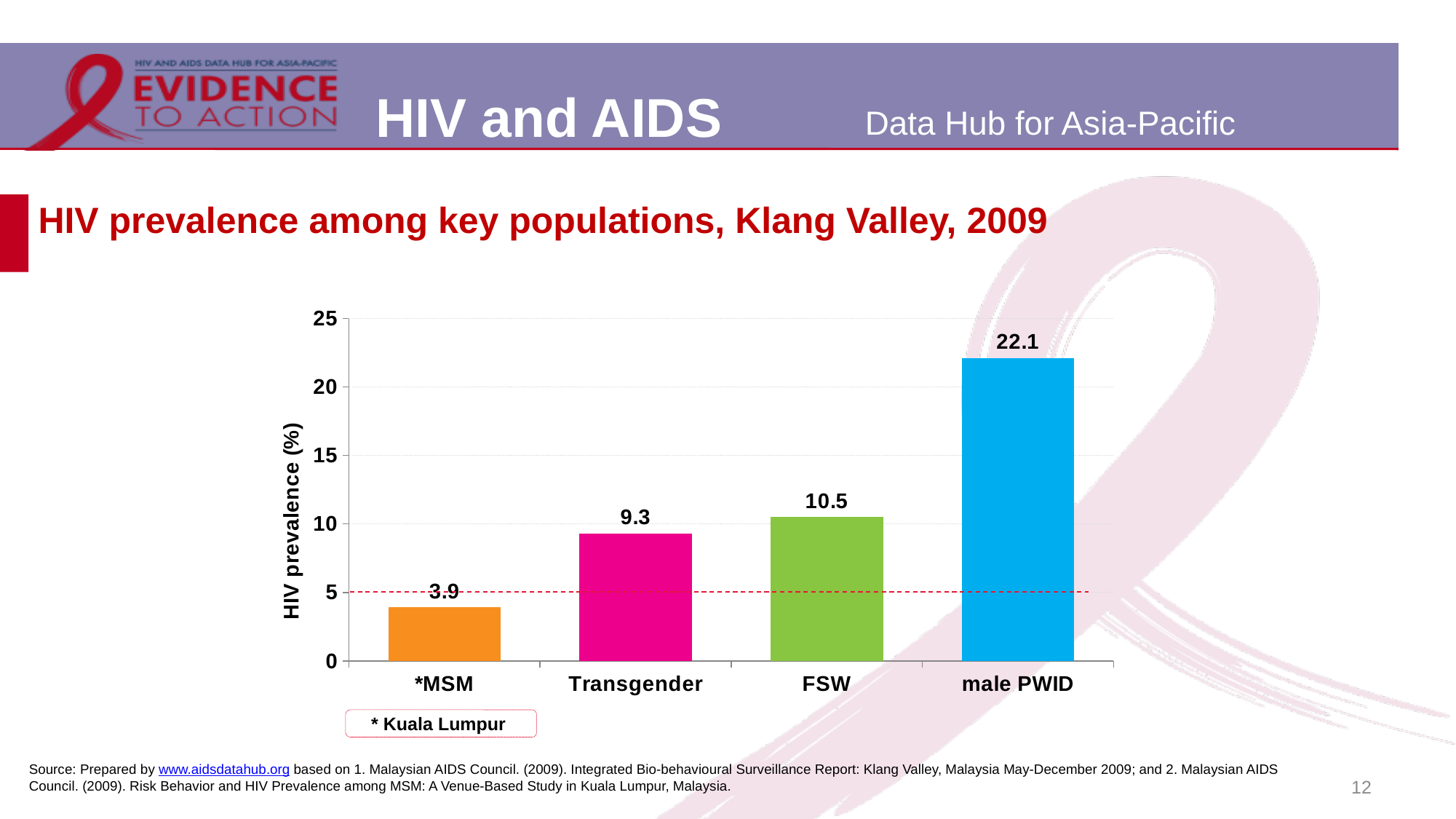
What is the difference in HIV prevalence between male PWID and FSW? 11.6 What is the label of the y axis? HIV prevalence (%) What is the HIV prevalence for male PWID? 22.1 What is the HIV prevalence for Transgender? 9.3 Which has a higher HIV prevalence, FSW or Transgender? FSW Which key population has the highest HIV prevalence? male PWID What kind of chart is shown on the slide? Bar chart What is the HIV prevalence for *MSM? 3.9 What is the HIV prevalence for FSW? 10.5 What is the difference in HIV prevalence between Transgender and *MSM? 5.4 Which key population has the lowest HIV prevalence? *MSM How many key populations are shown in the chart? 4